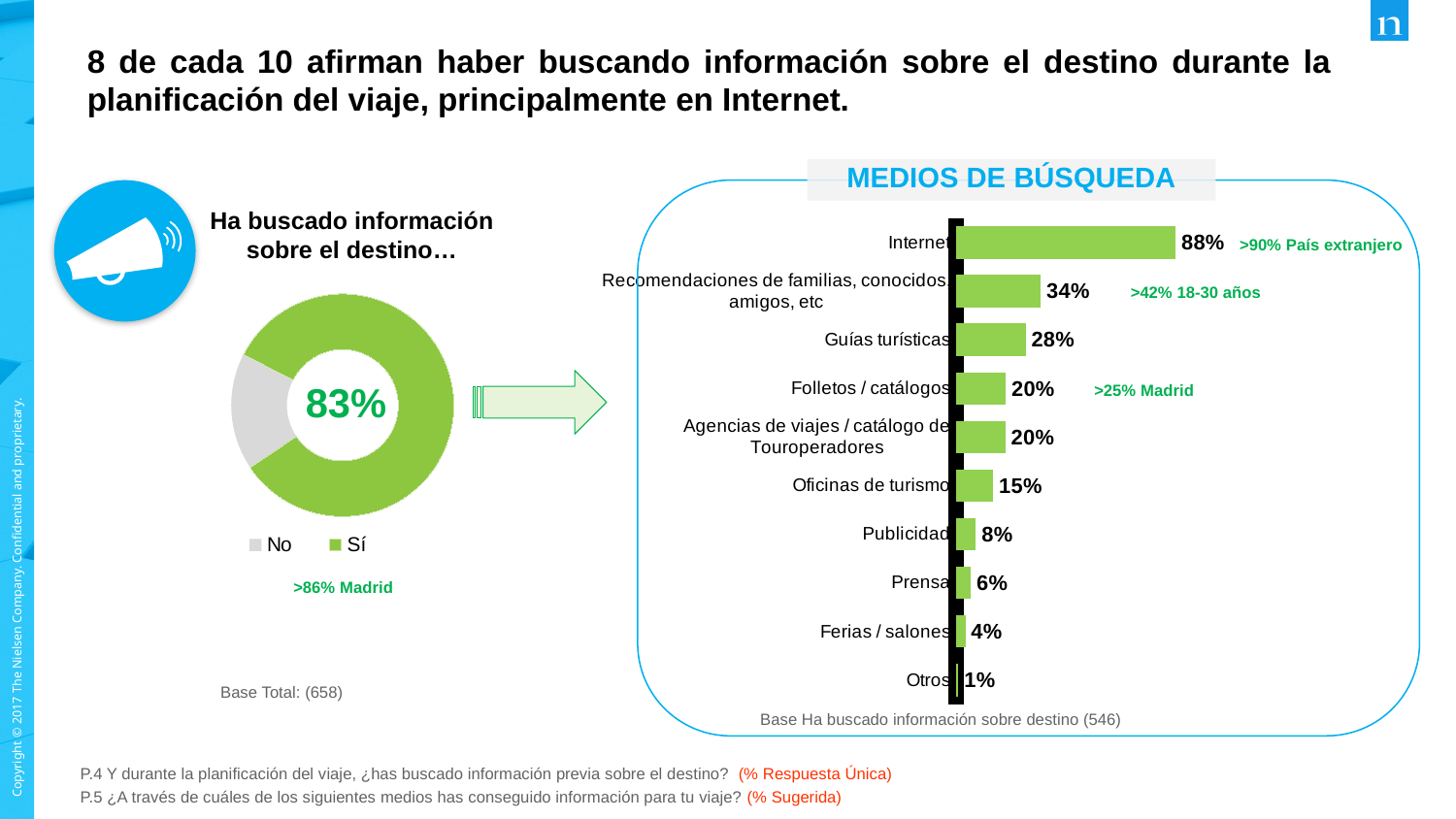
In the 'Medios de búsqueda' bar chart, what is the value for Internet? 88% How many categories are shown in the 'Medios de búsqueda' bar chart? 10 What kind of chart is the 'Medios de búsqueda' chart? Bar chart What is the title of the bar chart on the right of the slide? MEDIOS DE BÚSQUEDA How many entries does the legend of the donut chart 'Ha buscado información sobre el destino…' list? 2 In the 'Medios de búsqueda' bar chart, which category has the highest value? Internet In the 'Medios de búsqueda' bar chart, what is the value for Guías turísticas? 28% In the 'Medios de búsqueda' bar chart, what is the difference between Internet and Recomendaciones de familias, conocidos, amigos, etc? 54% In the 'Medios de búsqueda' bar chart, which category has the lowest value? Otros In the donut chart 'Ha buscado información sobre el destino…', what share corresponds to Sí? 83% In the 'Medios de búsqueda' bar chart, which is larger: Publicidad or Prensa? Publicidad In the 'Medios de búsqueda' bar chart, what is the value for Oficinas de turismo? 15%